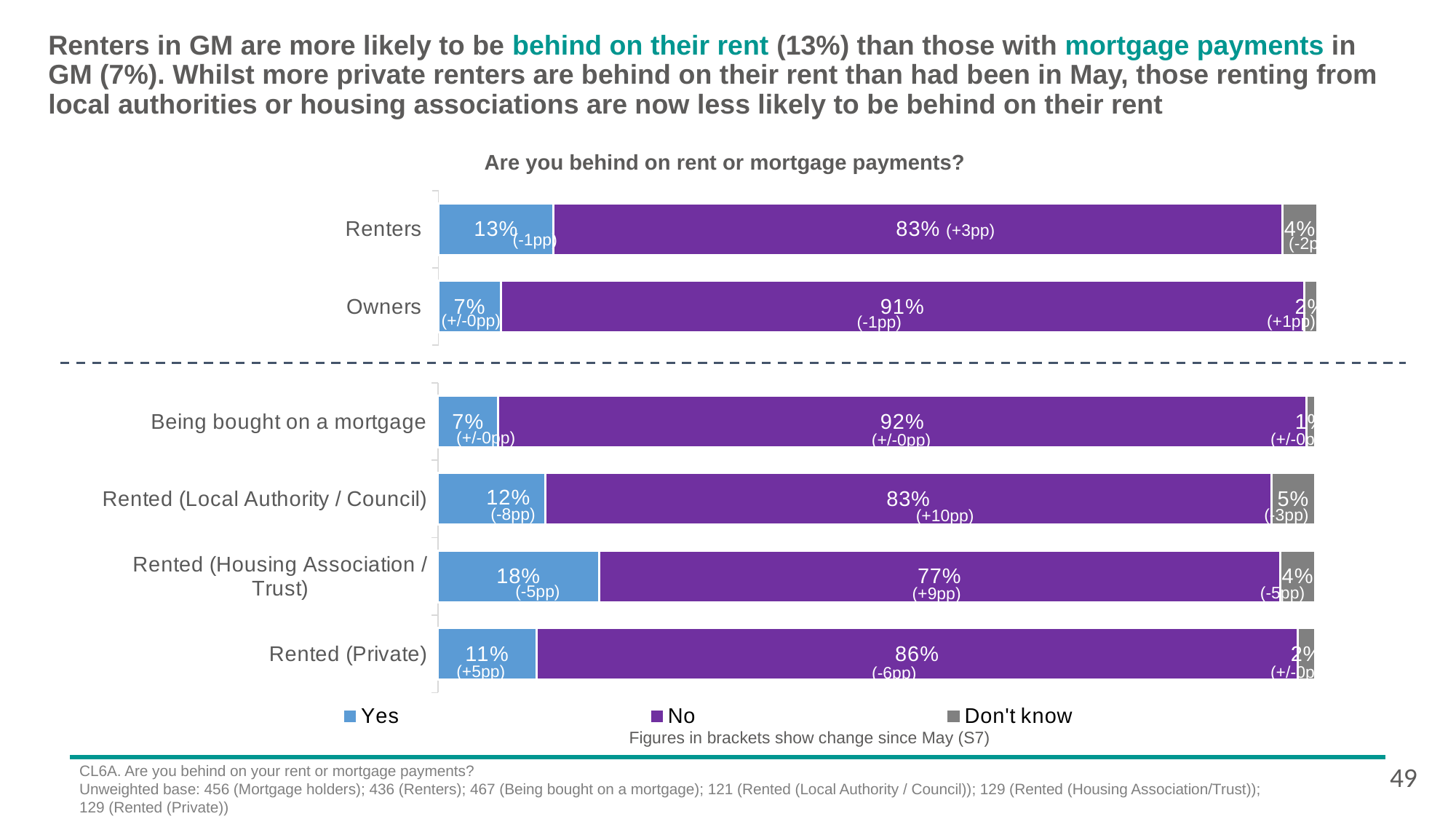
How many series does the legend list? 3 What is the title of the chart? Are you behind on rent or mortgage payments? Which has a larger "Yes" value: Rented (Local Authority / Council) or Rented (Private)? Rented (Local Authority / Council) Which category has the lowest "No" percentage? Rented (Housing Association / Trust) What is the "Yes" value for Rented (Housing Association / Trust)? 18% What is the "No" value for Owners? 91% How many categories are shown in the chart? 6 Which category has the highest "Yes" percentage? Rented (Housing Association / Trust) What is the "Don't know" value for Rented (Local Authority / Council)? 5% What is the difference between the "Yes" values for Renters and Owners? 6 percentage points What type of chart is shown on the slide? Stacked bar chart What percentage of Renters answered "Yes" to being behind on rent or mortgage payments? 13%